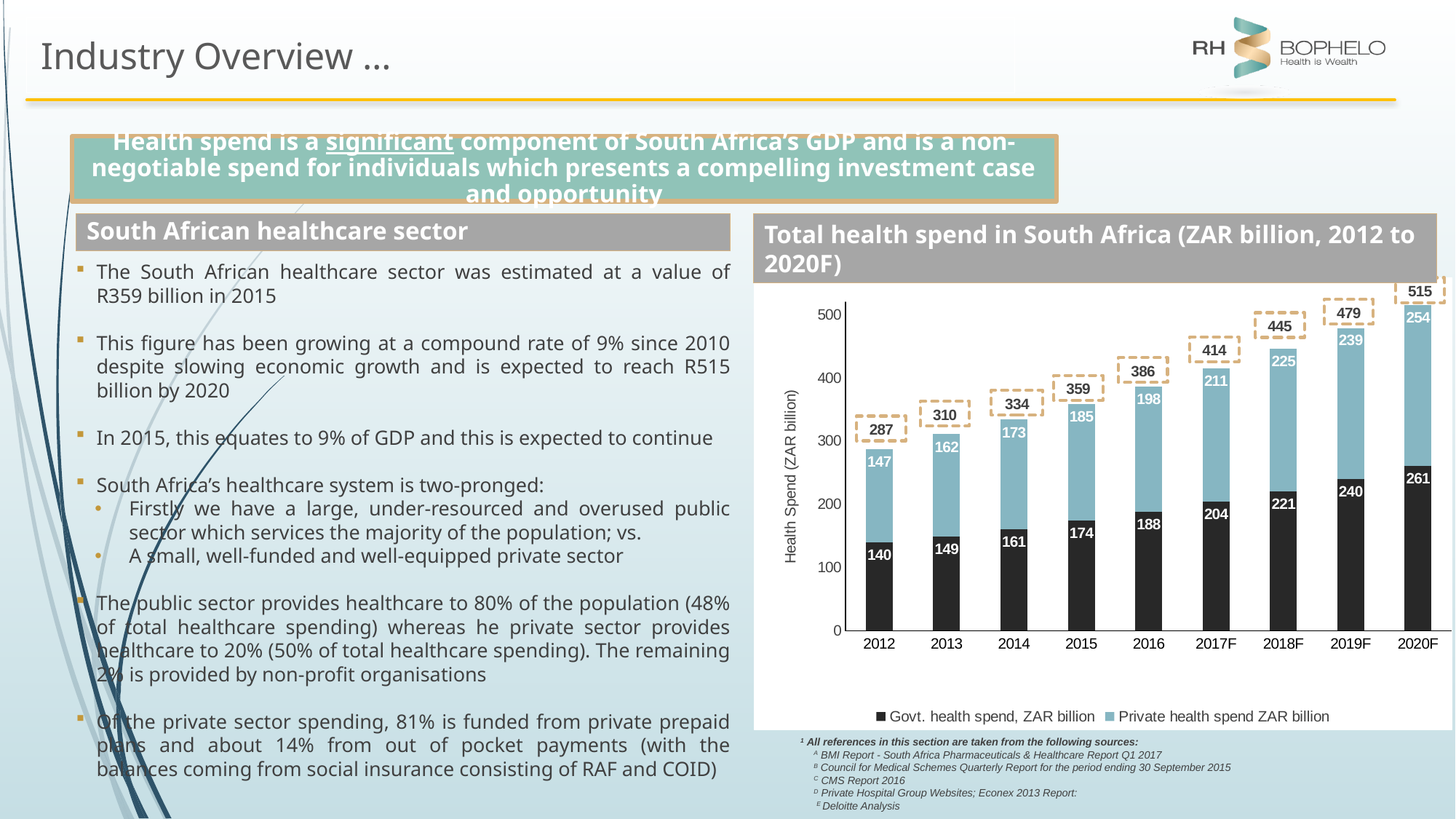
Is the total health spend for 2017F greater or less than 400? greater What is the Private health spend ZAR billion value for 2018F? 225 Which year has the highest Private health spend ZAR billion value? 2020F Which year has the lowest total health spend? 2012 Which is larger in 2016: Govt. health spend or Private health spend? Private health spend Do the total health spend values rise or fall from 2012 to 2020F? Rise What kind of chart is used to show total health spend in South Africa? Stacked bar chart How many series does the chart legend list? 2 What is the total health spend shown for 2020F? 515 How many years are shown on the x axis of the chart? 9 What is the difference between the total health spend in 2020F and in 2012? 228 What is the Govt. health spend, ZAR billion value for 2015? 174